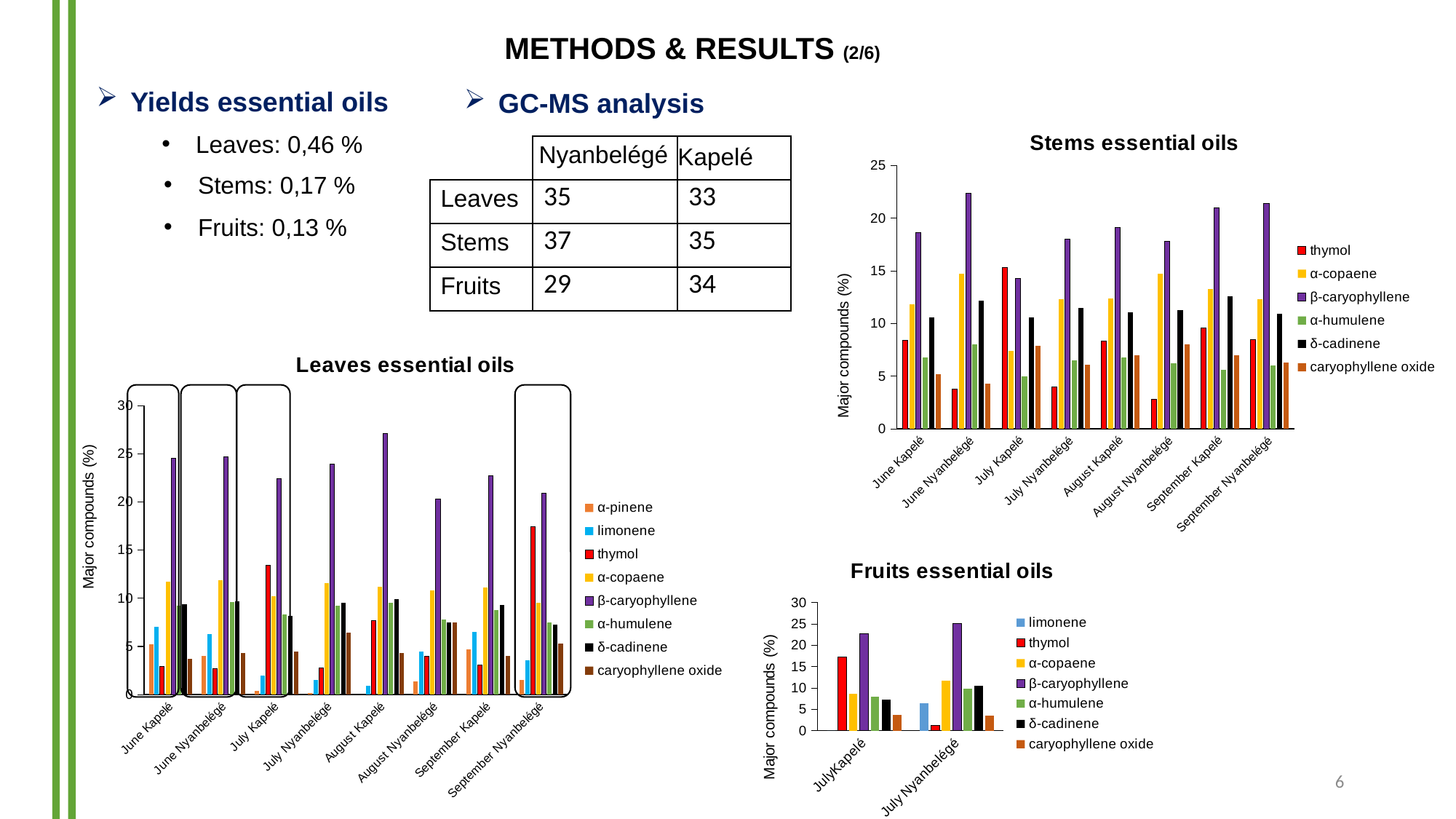
In the "Stems essential oils" chart, which category has the highest thymol value? July Kapelé How many categories are shown on the x axis of the "Stems essential oils" chart? 8 What kind of chart is the "Leaves essential oils" chart? bar chart In the "Stems essential oils" chart, is the β-caryophyllene value for June Kapelé greater or less than 15? greater How many series does the legend of the "Leaves essential oils" chart list? 8 In the "Fruits essential oils" chart, which category has the larger thymol value, July Kapelé or July Nyanbelégé? July Kapelé In the "Leaves essential oils" chart, which category has the highest thymol value? September Nyanbelégé How many categories are shown on the x axis of the "Fruits essential oils" chart? 2 In the "Leaves essential oils" chart, which category has the highest β-caryophyllene value? August Kapelé In the "Fruits essential oils" chart, is the β-caryophyllene value for July Nyanbelégé greater or less than 20? greater How many series does the legend of the "Stems essential oils" chart list? 6 What is the y-axis label of the "Stems essential oils" chart? Major compounds (%)